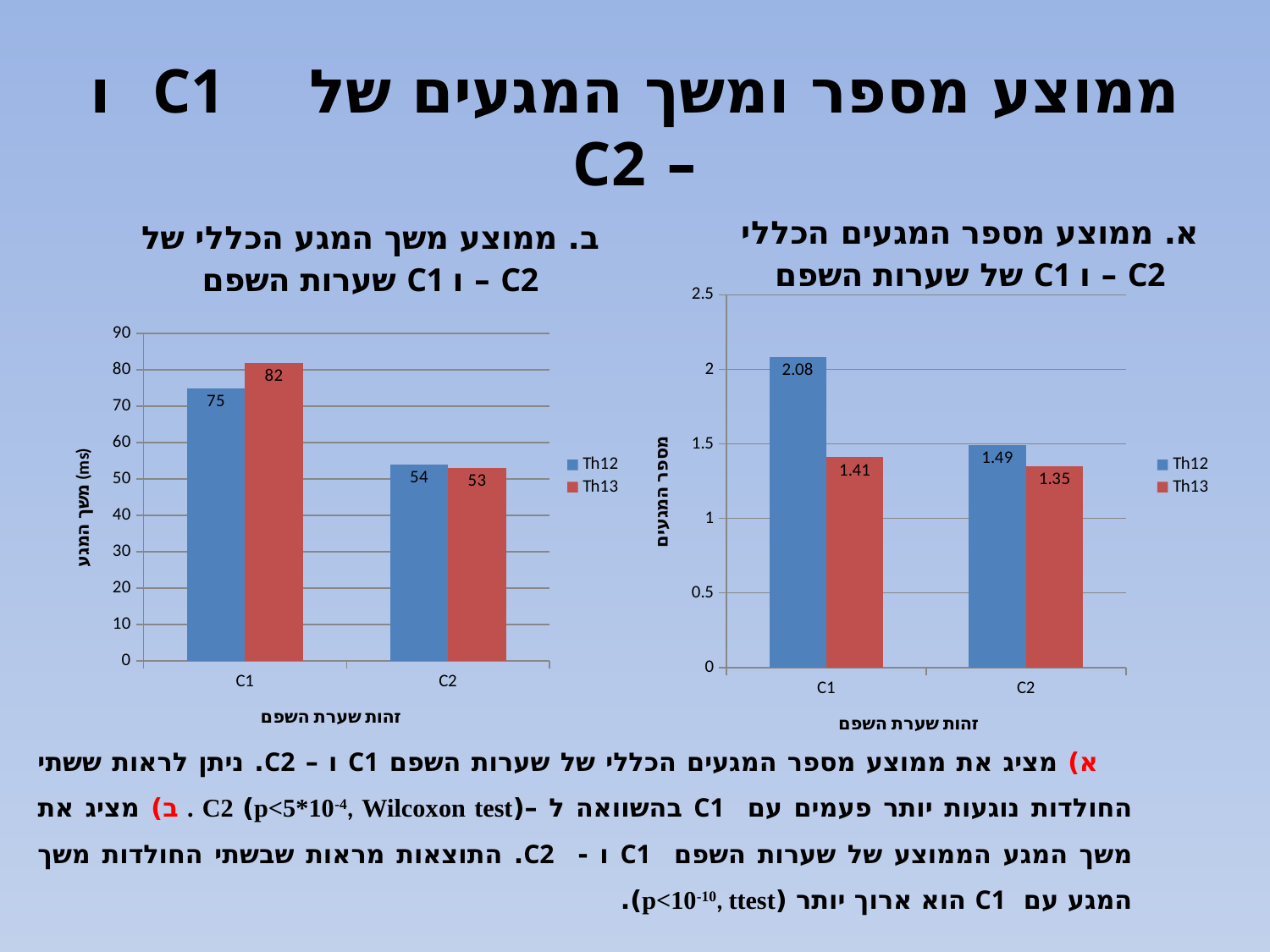
In the right chart (average number of contacts), what is the difference between Th12 and Th13 at C1? 0.67 In the left chart (average contact duration), what is the value for Th12 at C2? 54 In the right chart (average number of contacts), what is the value for Th13 at C2? 1.35 In the right chart (average number of contacts), which bar has the highest value? Th12 at C1 In the left chart (average contact duration), what is the difference between Th13 and Th12 at C1? 7 In the left chart, which colour represents Th13? Red In the left chart (average contact duration), which bar has the lowest value? Th13 at C2 In the left chart (average contact duration), which is larger at C1: Th12 or Th13? Th13 What kind of chart is the left chart? Bar chart How many series does the legend of the right chart list? 2 In the right chart (average number of contacts), what is the value for Th12 at C1? 2.08 In the left chart (average contact duration), what is the value for Th13 at C1? 82